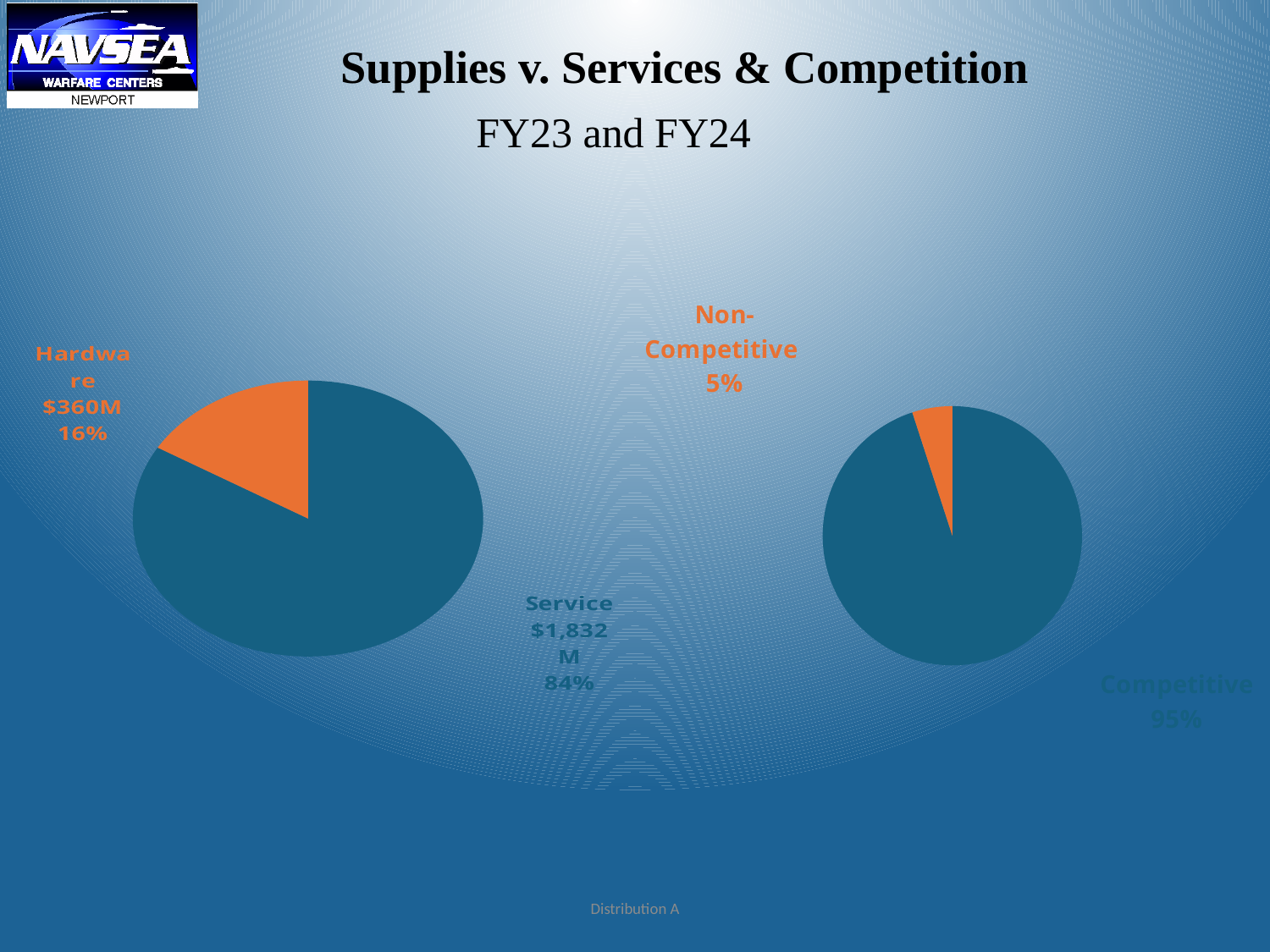
In the left pie chart, what is the value shown for Service? $1,832M In the right pie chart, what percentage is Non-Competitive? 5% What type of chart is used on the right side of the slide? Pie chart In the right pie chart, which slice is the smallest? Non-Competitive In the left pie chart, what is the value shown for Hardware? $360M In the right pie chart, what percentage is Competitive? 95% How many slices does the left pie chart have? 2 In the left pie chart, which slice is larger, Hardware or Service? Service What is the title of the slide containing the two charts? Supplies v. Services & Competition In the left pie chart, what percentage share does Service have? 84% In the left pie chart, what is the difference in dollars between Service and Hardware? $1,472M